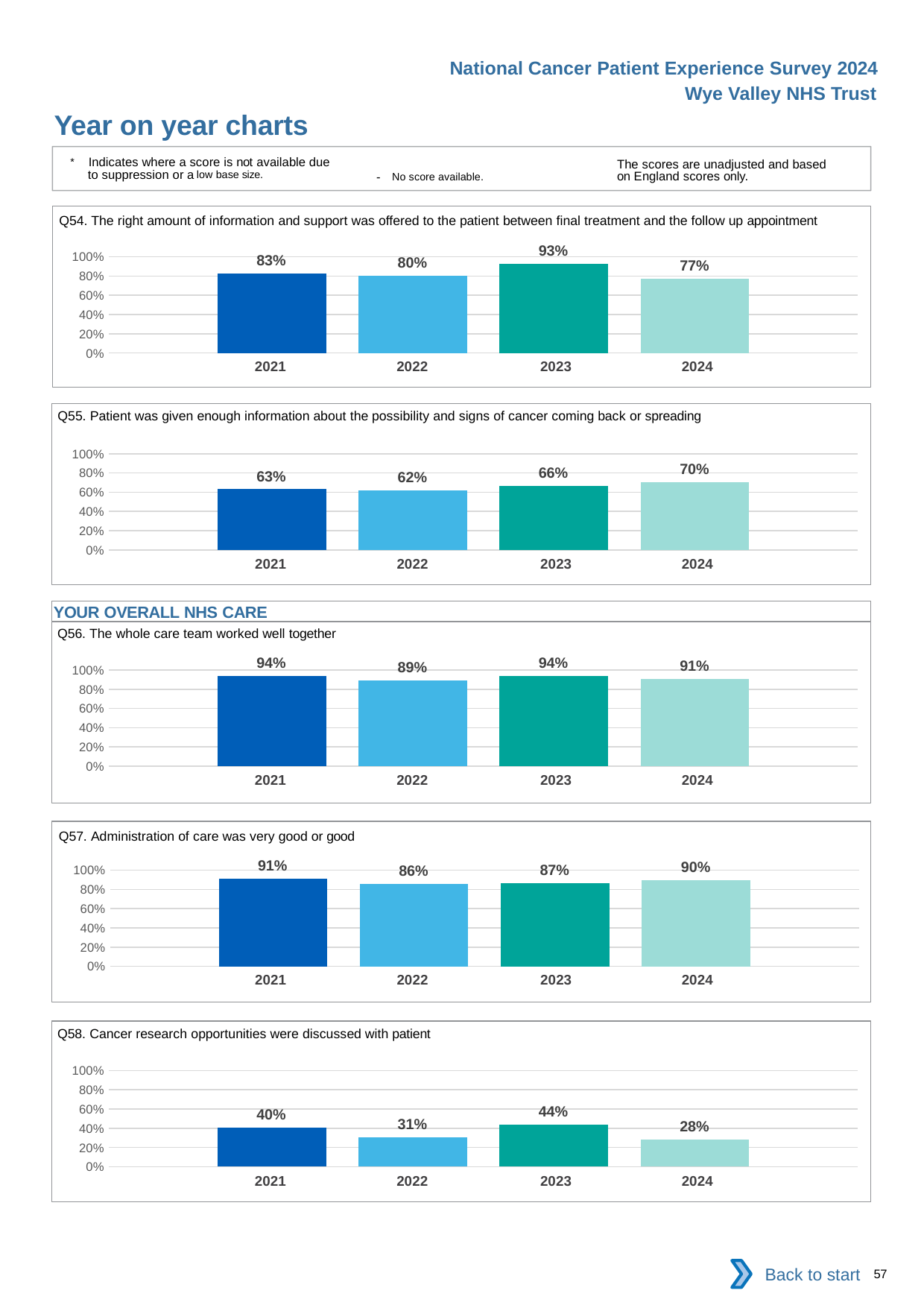
How many bars are shown in the Q58 chart? 4 What type of chart is the Q54 chart? Bar chart In the Q56 chart, which is larger, the value for 2022 or the value for 2024? 2024 In the Q58 chart, what is the value for 2024? 28% In the Q55 chart, what is the difference between the 2024 and 2021 values? 7% In the Q57 chart, which year has the highest value? 2021 In the Q54 chart, what is the value for 2023? 93% In the Q58 chart, which year has the highest value? 2023 In the Q55 chart, what is the value for 2024? 70% In the Q56 chart, what is the value for 2022? 89% In the Q54 chart, which year has the lowest value? 2024 In the Q57 chart, what is the difference between the 2021 and 2022 values? 5%